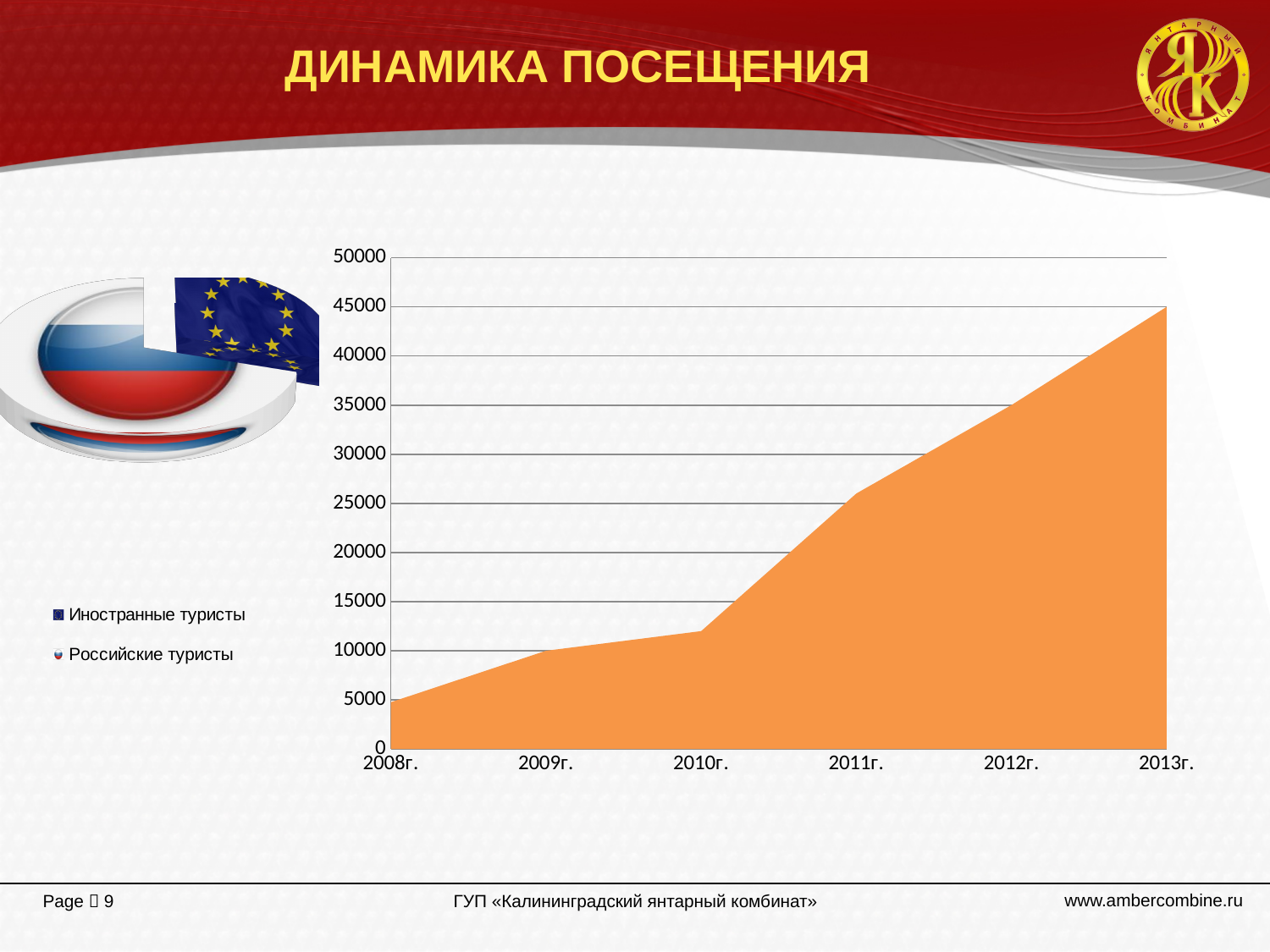
What is the title of the slide containing the chart? ДИНАМИКА ПОСЕЩЕНИЯ In the area chart, which year has the lowest value? 2008г. In the area chart, how many years are shown on the x axis? 6 In the area chart, is the value for 2012г. greater or less than 30000? greater In the area chart, is the value for 2013г. greater or less than 40000? greater In the area chart, do the values rise or fall from 2008г. to 2013г.? rise How many entries does the legend on the left of the slide list? 2 In the area chart, which year has the larger value, 2009г. or 2011г.? 2011г. In the area chart, is the value for 2011г. greater or less than 25000? greater What kind of chart is the large chart on the right of the slide? area chart In the area chart, which year has the highest value? 2013г.